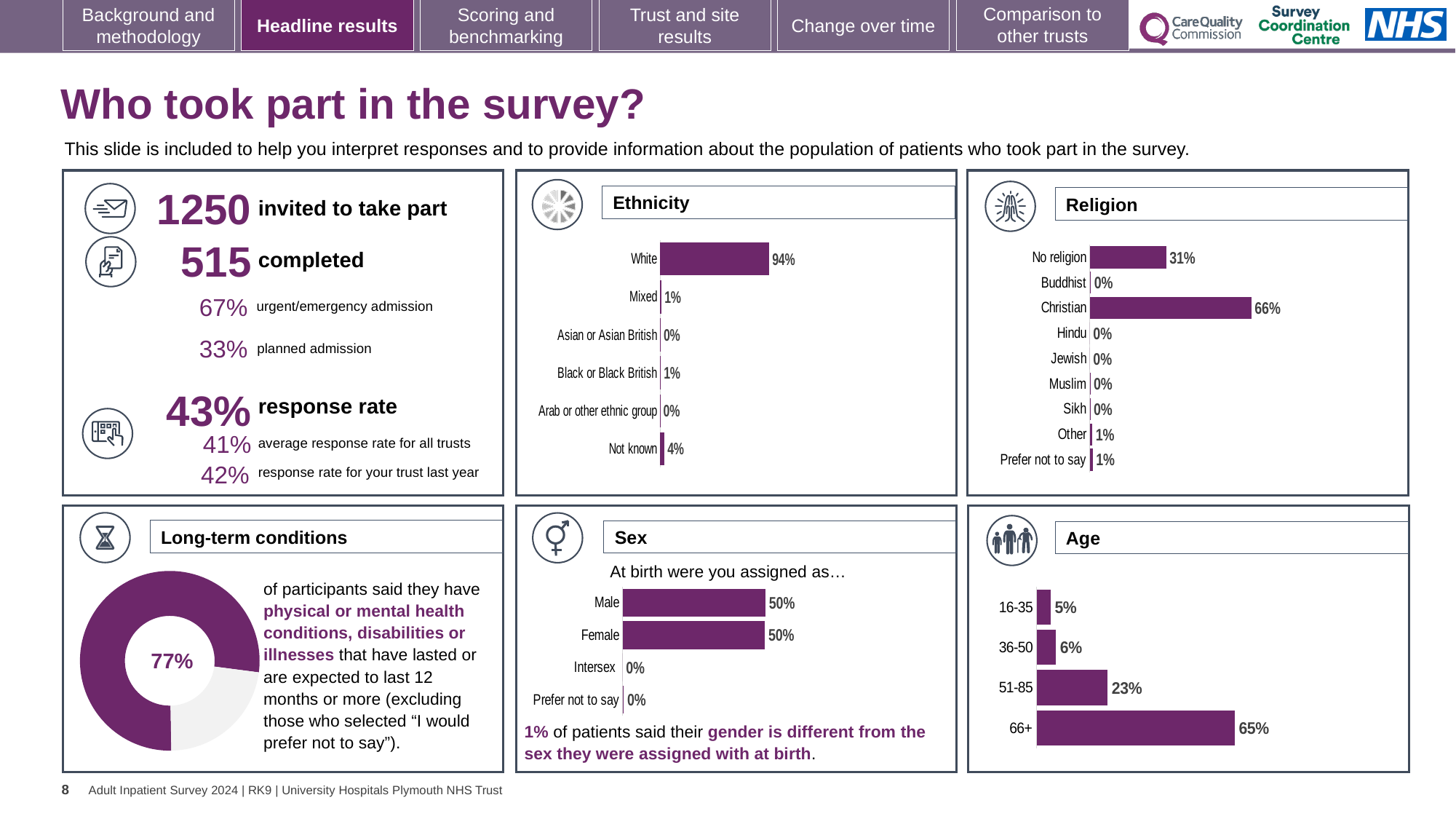
In the Ethnicity chart, what percentage of respondents are White? 94% In the Ethnicity chart, which category has the highest value? White What kind of chart is the Long-term conditions chart? Doughnut chart In the Religion chart, what percentage of respondents are Christian? 66% In the Age chart, what is the value for 51-85? 23% In the Long-term conditions chart, what share of participants said they have physical or mental health conditions, disabilities or illnesses? 77% In the Age chart, which is larger, 16-35 or 36-50? 36-50 In the Religion chart, what is the difference between Christian and No religion? 35% In the Sex chart, what percentage of respondents were assigned Female at birth? 50% In the Age chart, which age group has the highest value? 66+ How many categories does the Religion chart show? 9 In the Ethnicity chart, what is the value for Not known? 4%